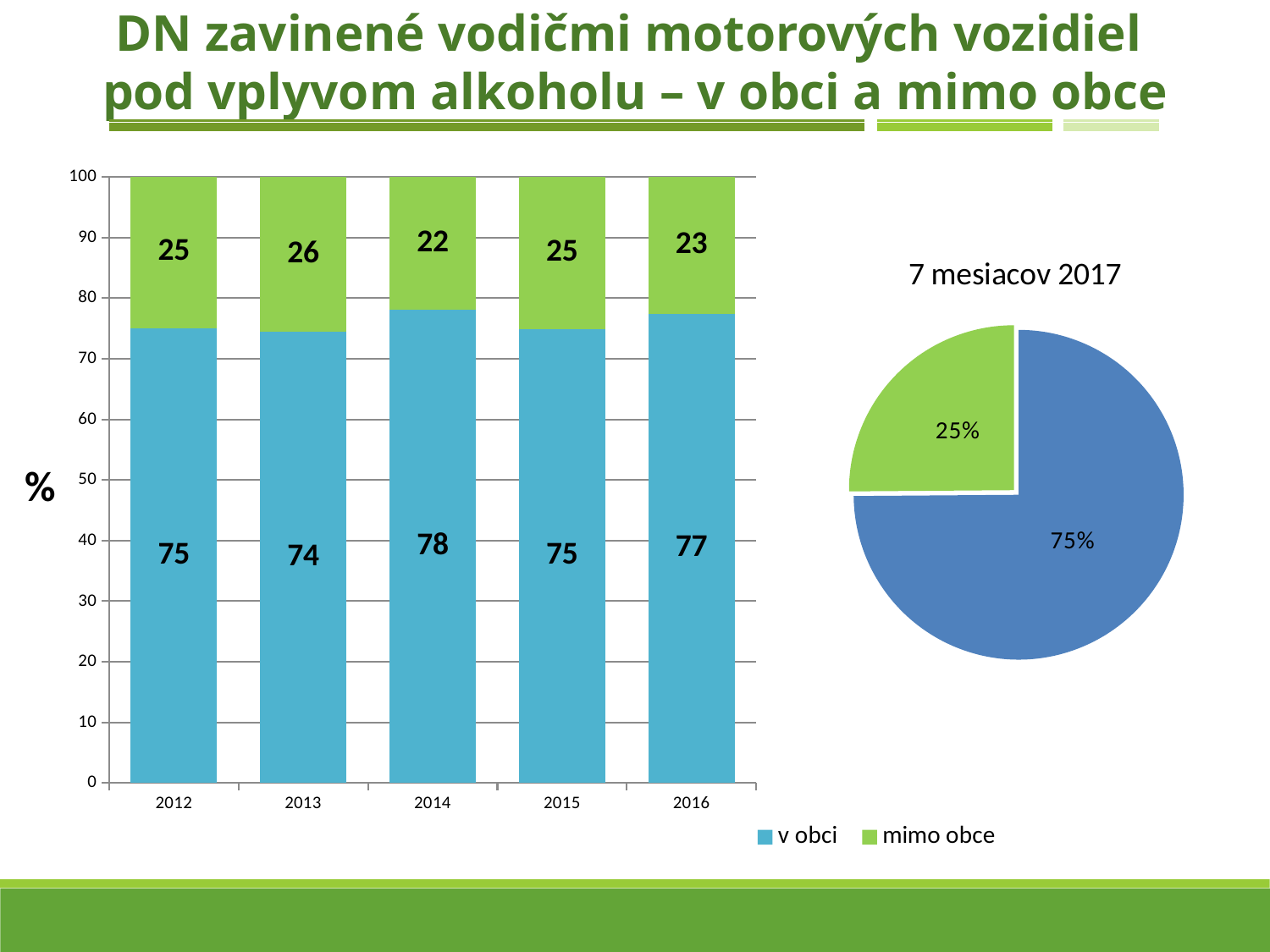
In the pie chart titled '7 mesiacov 2017', what share does the green slice represent? 25% In the stacked bar chart on the left, what is the total of the stacked bar for 2016? 100 In the stacked bar chart on the left, how many years are shown on the x axis? 5 In the stacked bar chart on the left, which year has the highest value for 'v obci'? 2014 In the stacked bar chart on the left, which year has the lowest value for 'mimo obce'? 2014 In the stacked bar chart on the left, how many series does the legend list? 2 What is the title of the pie chart on the right of the slide? 7 mesiacov 2017 In the stacked bar chart on the left, what is the difference between the 'v obci' value in 2014 and in 2013? 4 In the stacked bar chart on the left, which is larger: the 'mimo obce' value in 2013 or in 2016? 2013 In the stacked bar chart on the left, what is the value for 'mimo obce' in 2013? 26 In the stacked bar chart on the left, what is the value for 'v obci' in 2014? 78 What kind of chart is the chart on the left of the slide? Stacked bar chart